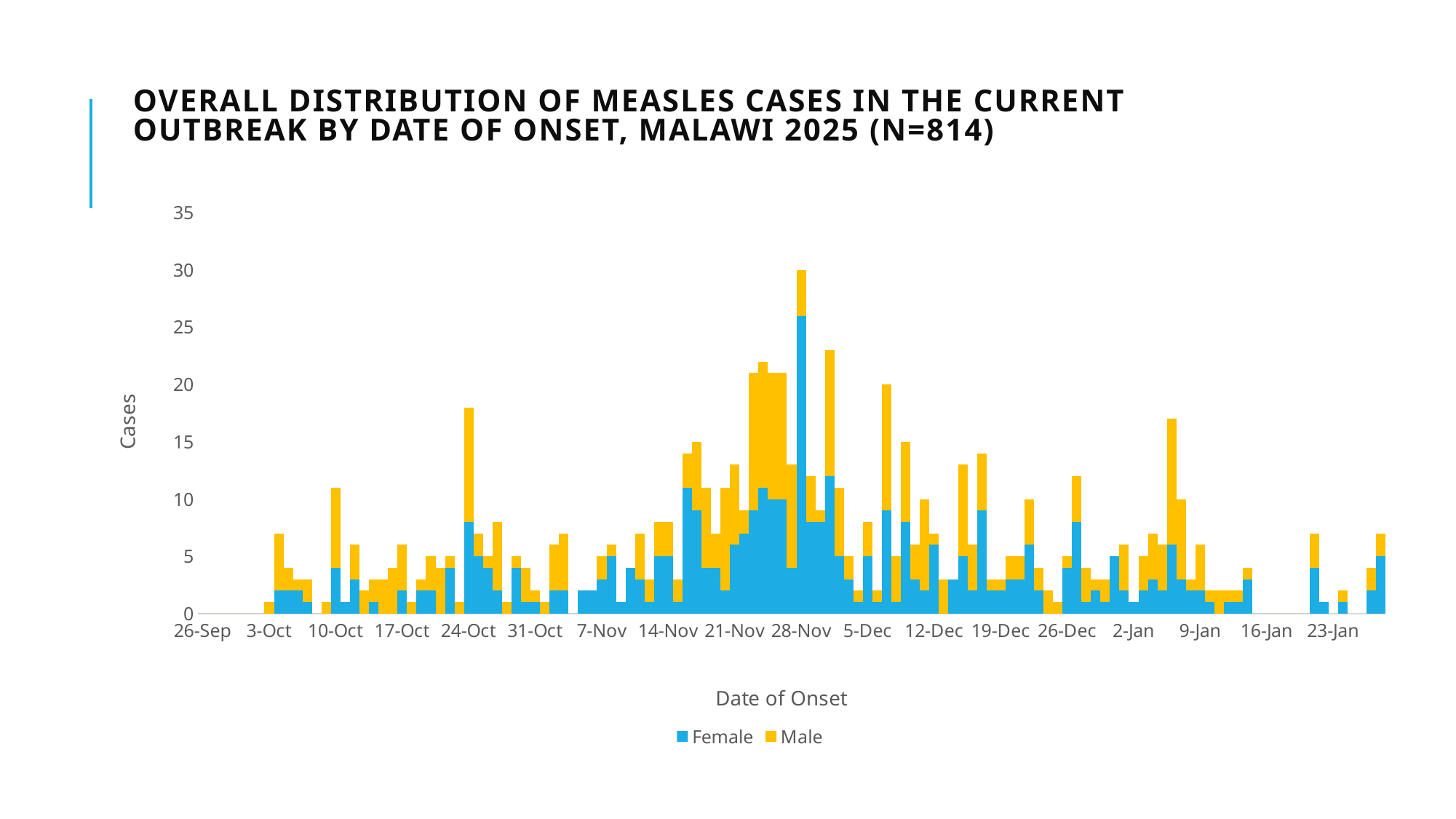
Is the number of cases at 16-Jan greater or less than 5? less What are the two series named in the legend? Female and Male Is the total number of cases for the bar at 24-Oct greater or less than 15? greater Do the daily case counts generally rise or fall between 28-Nov and 16-Jan? fall What kind of chart is shown on the slide? bar chart How many series does the legend list? 2 Is the total number of cases for the bar at 21-Nov greater or less than 10? greater At which labelled date on the x axis does the tallest bar occur? 28-Nov Which series is shown in blue? Female